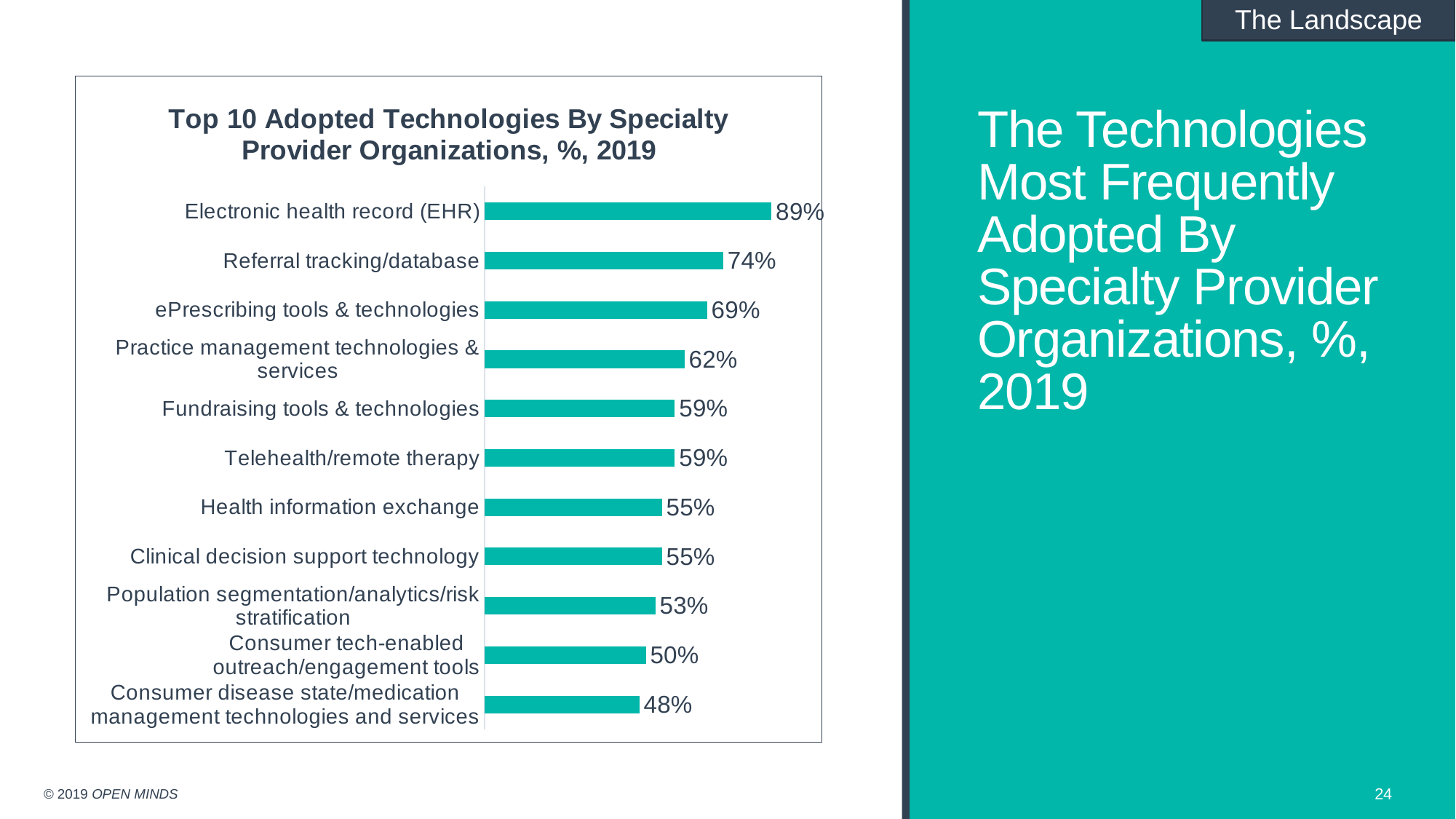
What is the difference between the values for ePrescribing tools & technologies and Practice management technologies & services? 7% What is the value for Electronic health record (EHR)? 89% What is the value for Consumer disease state/medication management technologies and services? 48% Which category has the lowest value? Consumer disease state/medication management technologies and services Which category has the highest value? Electronic health record (EHR) What is the difference between the values for Electronic health record (EHR) and Referral tracking/database? 15% Which is larger, the value for Health information exchange or the value for Population segmentation/analytics/risk stratification? Health information exchange What kind of chart is shown on the slide? Bar chart How many categories are shown in the chart? 11 What is the title of the chart? Top 10 Adopted Technologies By Specialty Provider Organizations, %, 2019 What is the value for Referral tracking/database? 74% What is the value for Telehealth/remote therapy? 59%